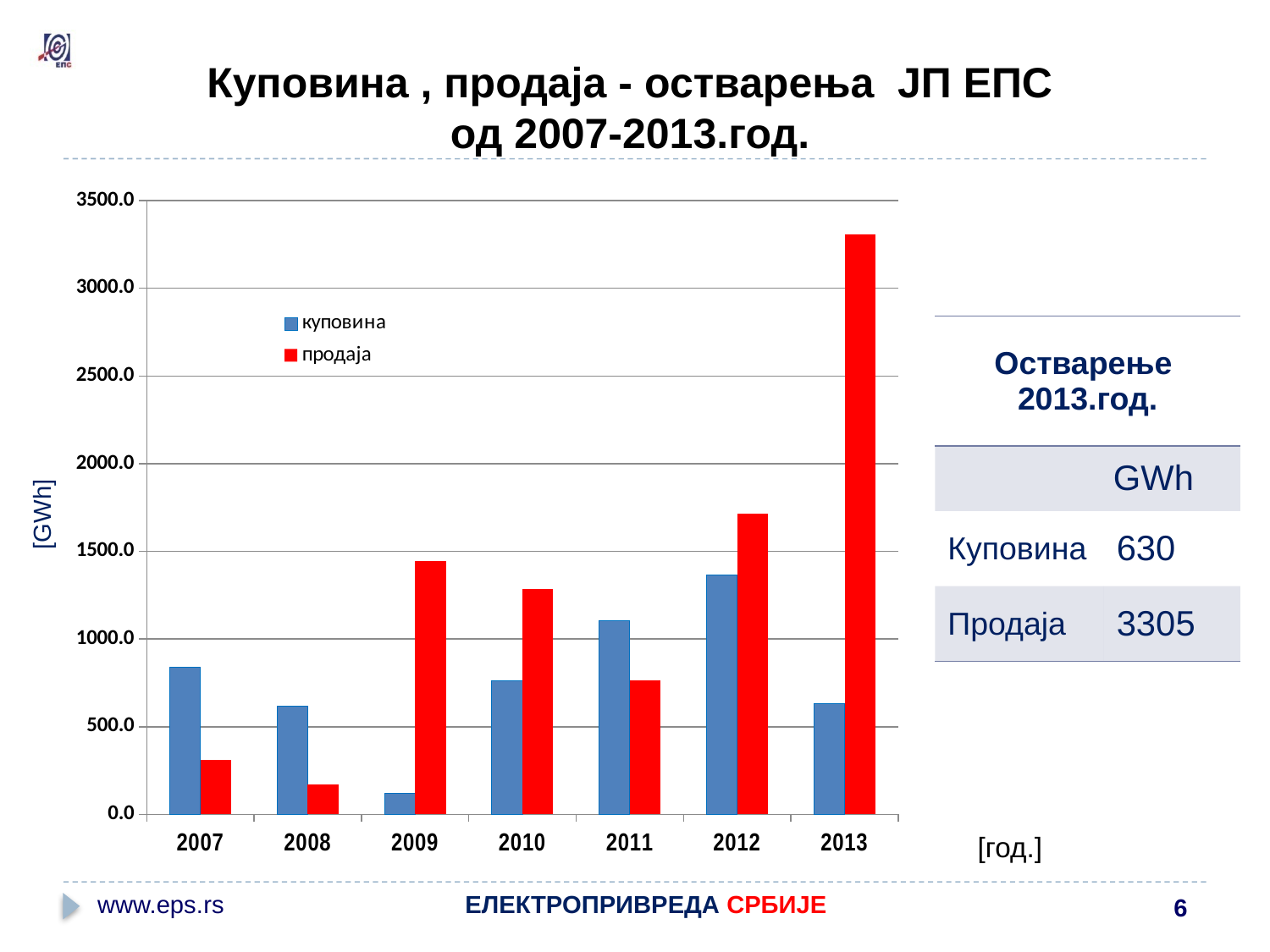
According to the table on the slide, what is the value of Куповина for 2013 in GWh? 630 How many years are shown on the x axis of the chart? 7 In which year is the продаја (red) bar the highest? 2013 In 2007, which is larger: куповина or продаја? куповина In which year is the куповина (blue) bar the highest? 2012 What is the difference between Продаја and Куповина in 2013, in GWh? 2675 In which year is the куповина (blue) bar the lowest? 2009 In which year is the продаја (red) bar the lowest? 2008 Is the value for продаја in 2012 greater or less than 1500? greater According to the table on the slide, what is the value of Продаја for 2013 in GWh? 3305 How many series does the chart legend list? 2 What type of chart is shown on the slide? bar chart